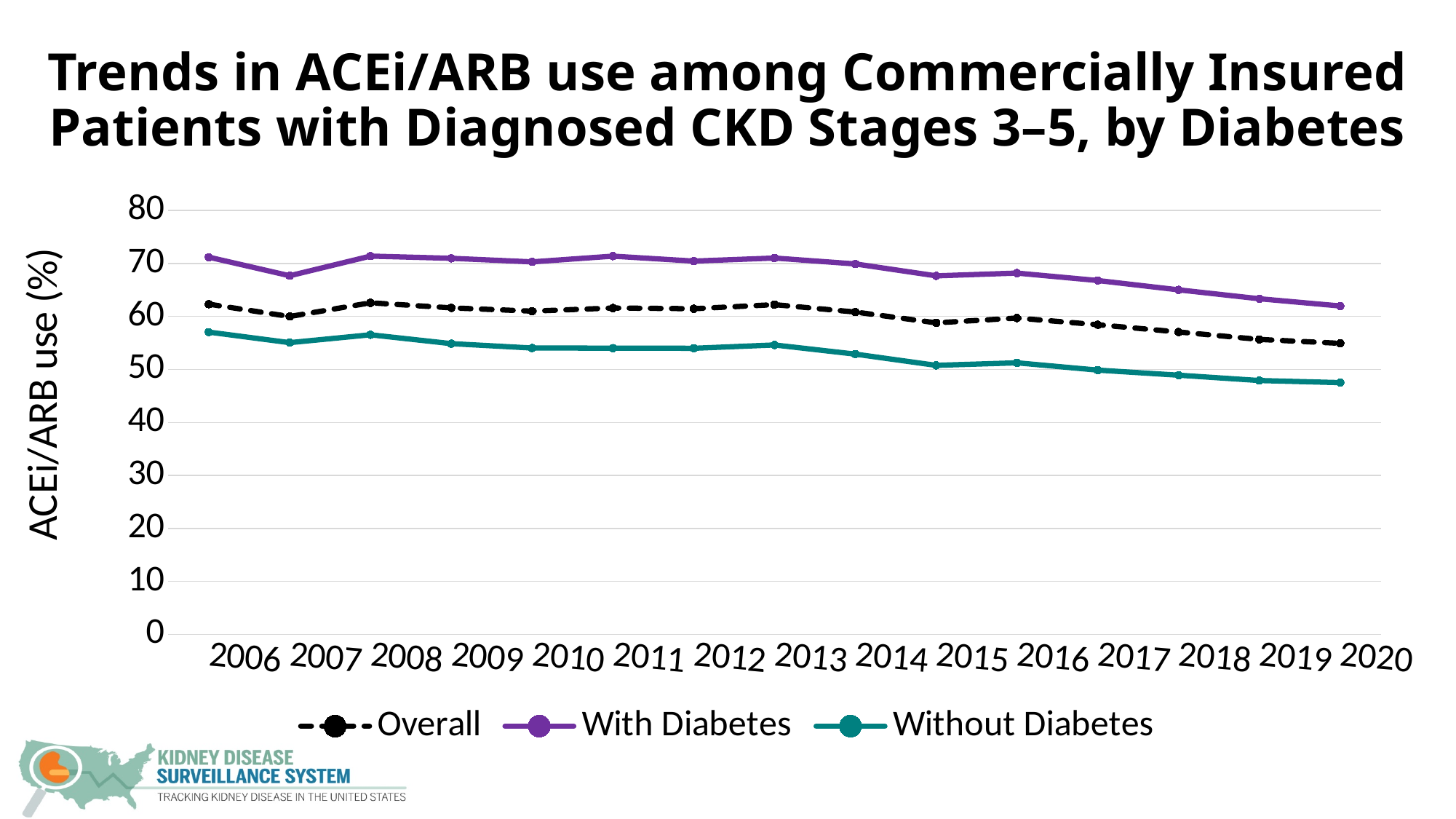
Is the value for With Diabetes in 2020 greater or less than 70? less In 2010, which is larger: the value for With Diabetes or the value for Without Diabetes? With Diabetes Does the Without Diabetes line rise or fall from 2006 to 2020? Fall Does the With Diabetes line rise or fall from 2016 to 2020? Fall What is the label on the y axis? ACEi/ARB use (%) Is the value for Without Diabetes in 2020 greater or less than 50? less How many years are plotted along the x axis? 15 Which series has the lowest values across all years? Without Diabetes Is the value for Overall in 2006 greater or less than 60? greater What kind of chart is shown on the slide? Line chart How many series does the legend list? 3 Which series has the highest values across all years? With Diabetes